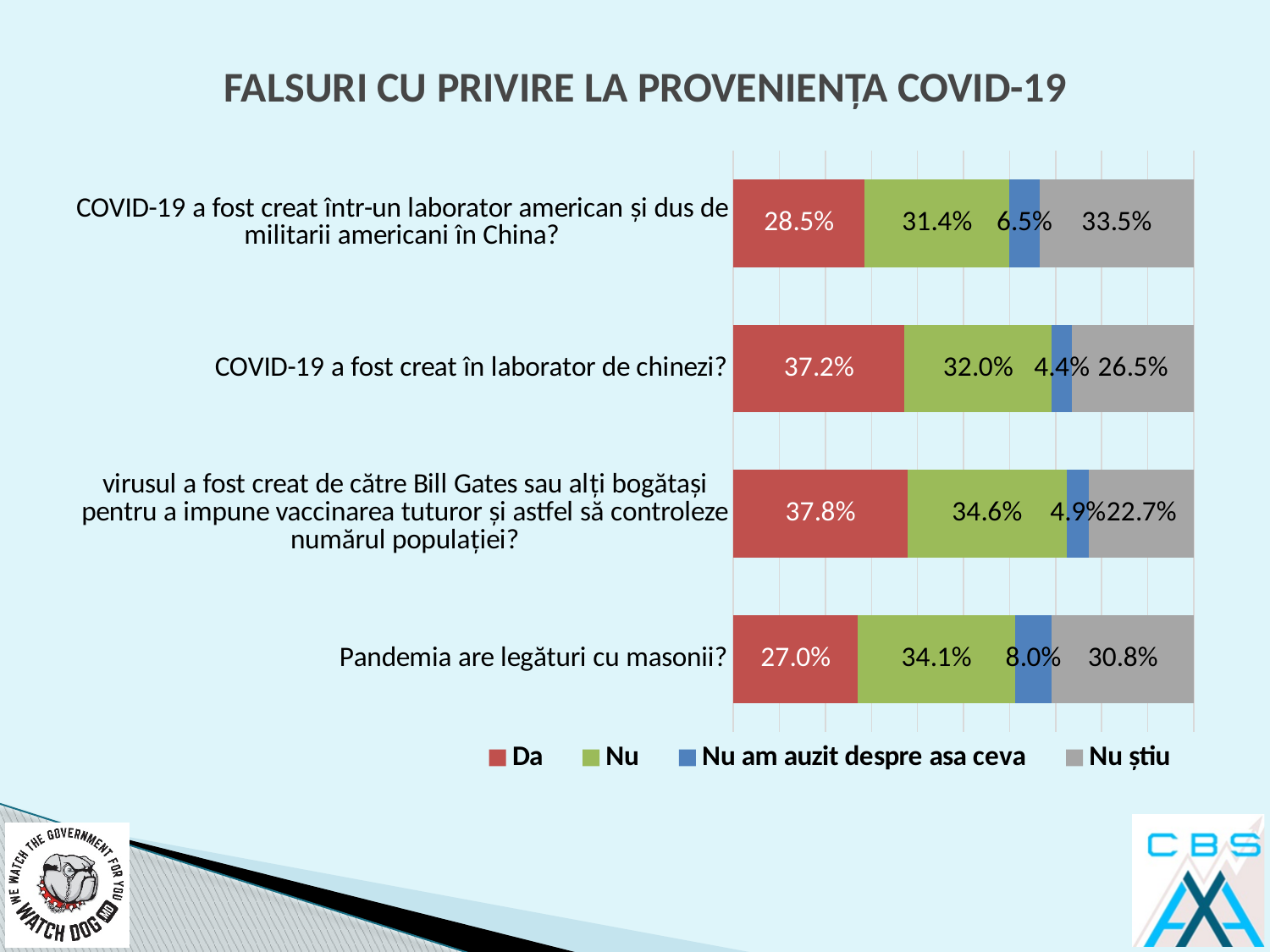
What is the "Nu știu" value for "Pandemia are legături cu masonii?"? 30.8% What is the "Nu am auzit despre asa ceva" value for the statement that COVID-19 was created in an American laboratory and brought to China by American soldiers? 6.5% How many statements (categories) are shown in the chart? 4 What type of chart is shown on the slide? Stacked bar chart Which is larger: the "Nu știu" share for "Pandemia are legături cu masonii?" or for the Bill Gates statement? Pandemia are legături cu masonii? Which statement has the highest "Da" share? virusul a fost creat de către Bill Gates sau alți bogătași pentru a impune vaccinarea tuturor și astfel să controleze numărul populației? By how many percentage points does the "Da" share for "COVID-19 a fost creat în laborator de chinezi?" exceed the "Da" share for the American laboratory statement? 8.7 percentage points What percentage answered "Nu" to the statement that the virus was created by Bill Gates or other rich people to impose vaccination? 34.6% Which statement has the highest "Nu știu" share? COVID-19 a fost creat într-un laborator american și dus de militarii americani în China? Which statement has the lowest "Nu am auzit despre asa ceva" share? COVID-19 a fost creat în laborator de chinezi? What percentage answered "Da" to "COVID-19 a fost creat în laborator de chinezi?"? 37.2% How many series does the legend list? 4